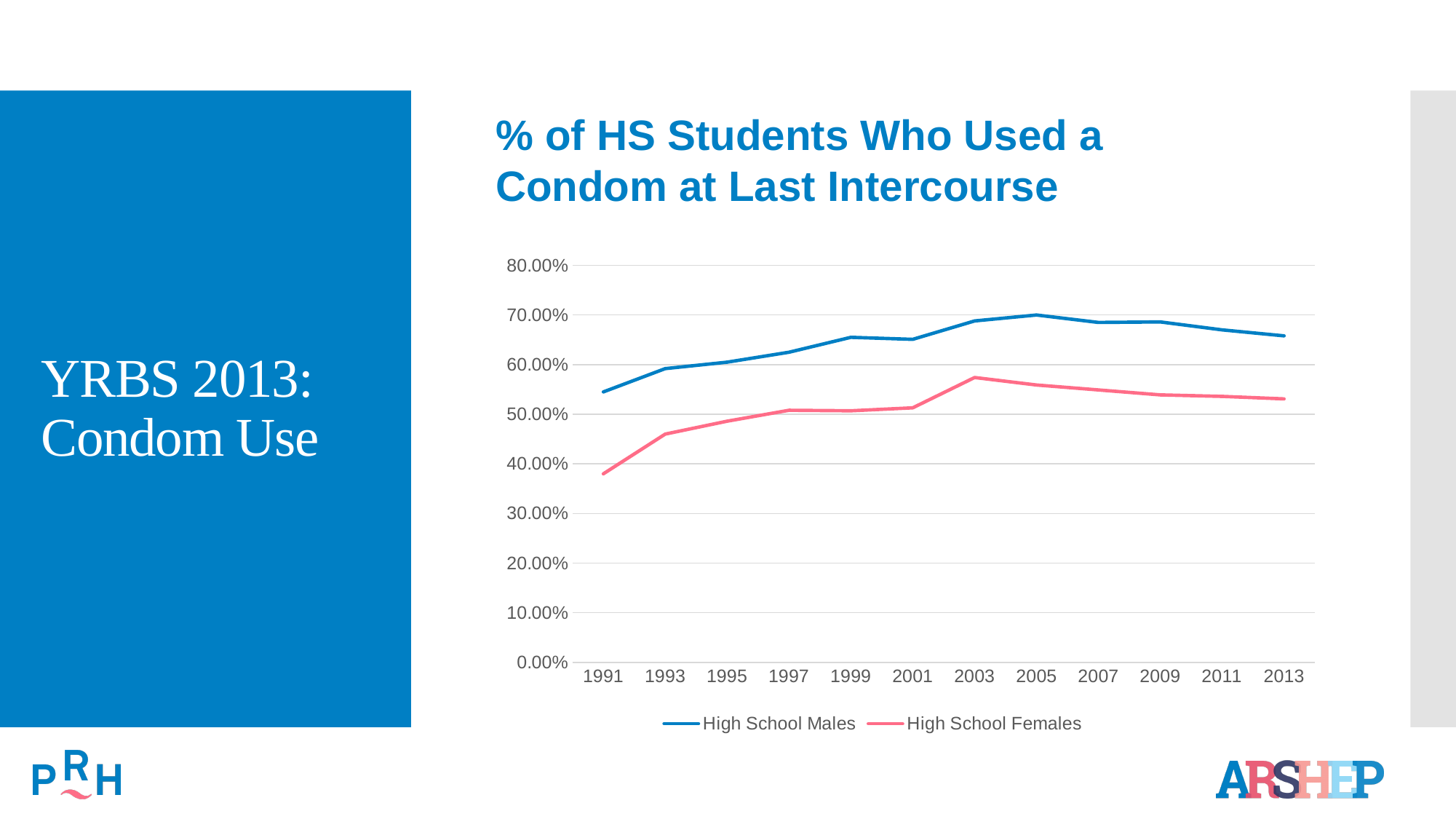
How many series does the legend list? 2 What is the title of the chart? % of HS Students Who Used a Condom at Last Intercourse Which series is plotted in pink? High School Females Is the value for High School Males in 2013 greater or less than 60.00%? greater Which series has the larger value in 2013, High School Males or High School Females? High School Males How many years are plotted along the x axis? 12 In which year is the value for High School Males highest? 2005 In which year is the value for High School Females highest? 2003 Is the value for High School Females in 1991 greater or less than 40.00%? less What kind of chart is shown on the slide? Line chart In which year is the value for High School Females lowest? 1991 Does the value for High School Females rise or fall from 1991 to 2003? Rise